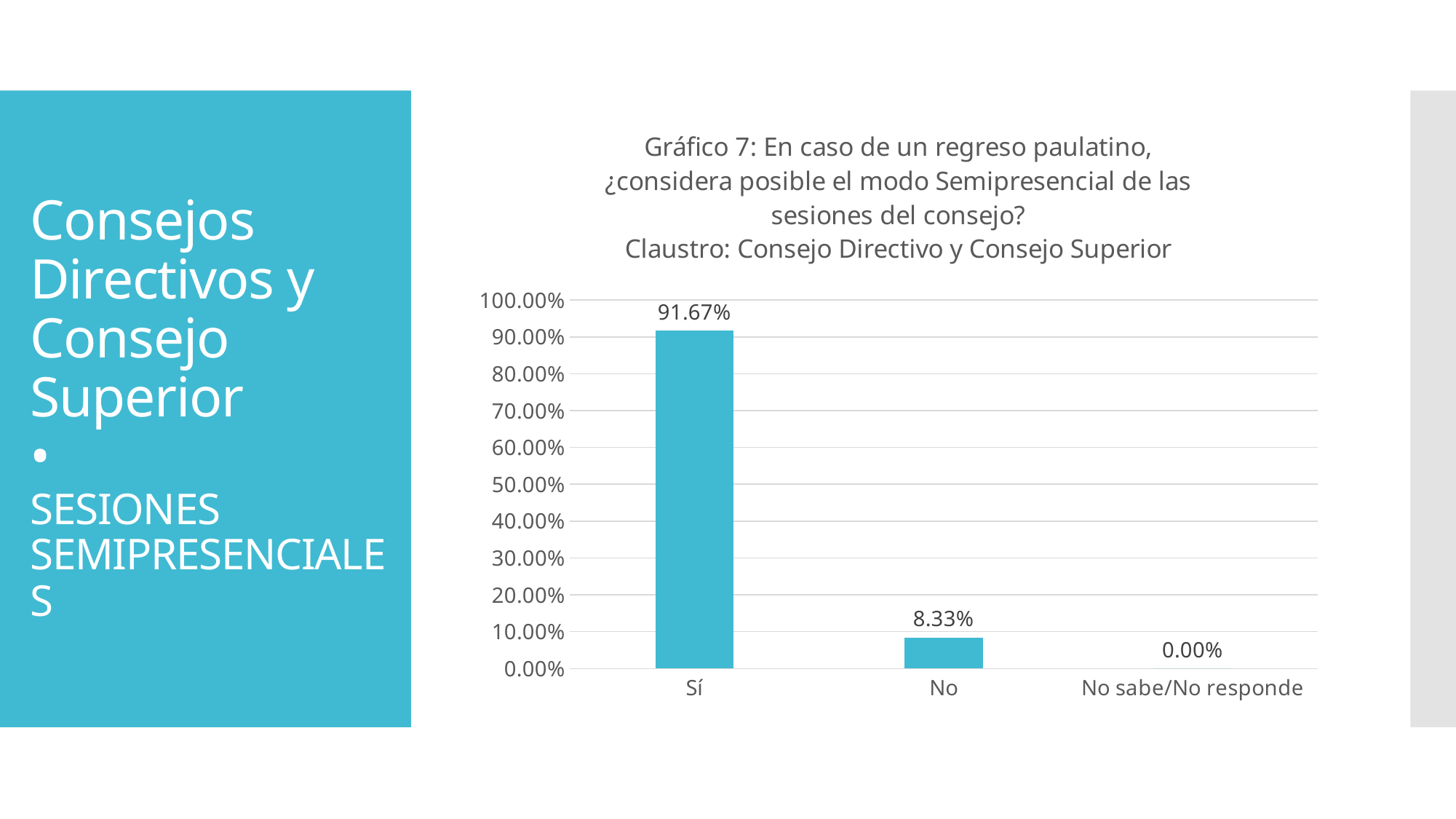
What is the value for No sabe/No responde? 0.00% How many categories are shown on the x axis? 3 Which category has the lowest value? No sabe/No responde What is the difference between the values for Sí and No? 83.34% Which is larger, the value for Sí or the value for No? Sí What is the value for Sí? 91.67% Which category has the highest value? Sí Which claustro does the chart title say the data is for? Consejo Directivo y Consejo Superior Is the value for Sí greater or less than 90.00%? greater What is the value for No? 8.33% What kind of chart is shown on the slide? bar chart Is the value for No greater or less than 10.00%? less